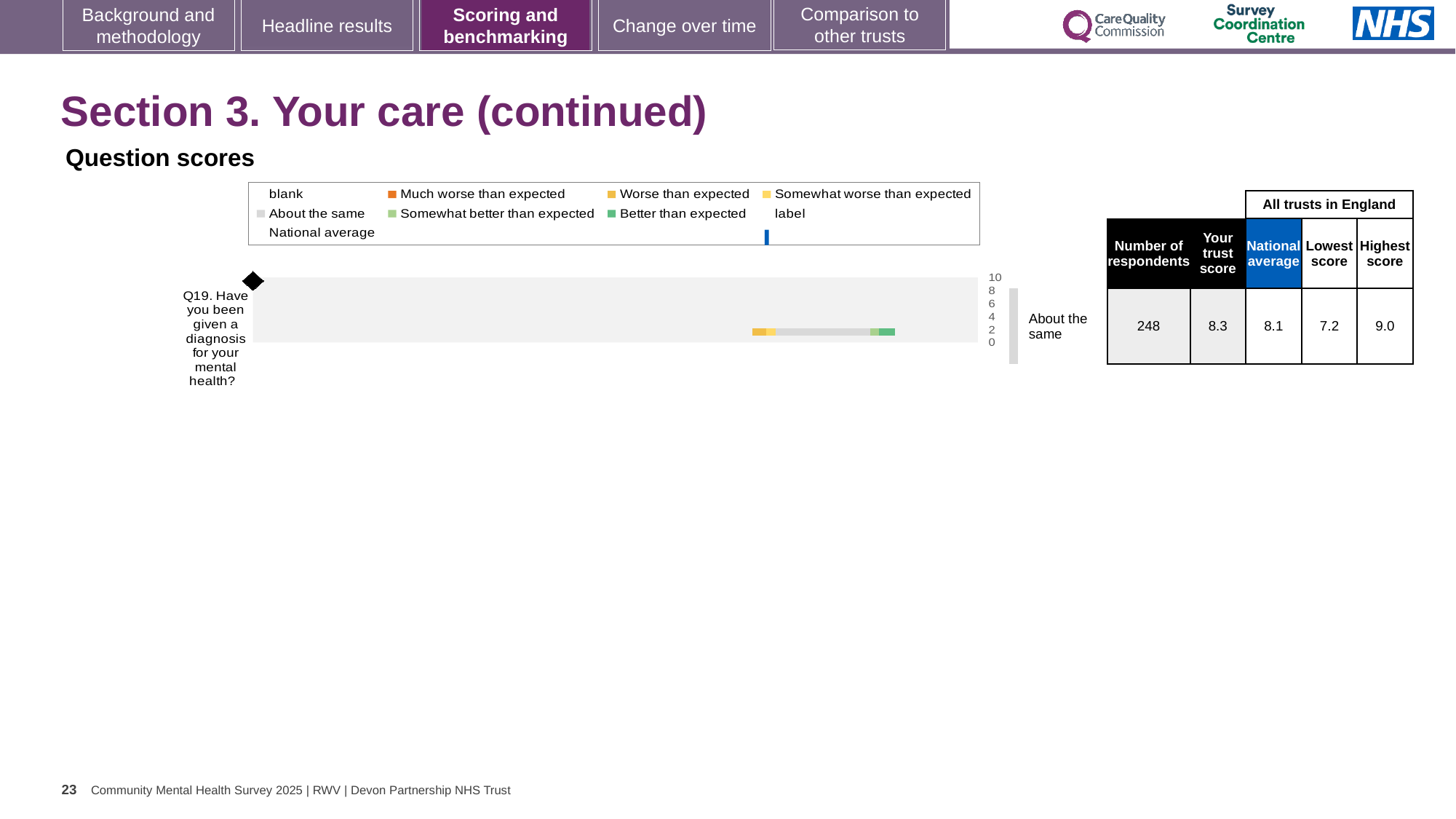
What is the difference between the highest score and the lowest score for Q19? 1.8 How many questions are plotted in the 'Question scores' chart? 1 What benchmark category is shown next to the bar for Q19? About the same What is the number of respondents for Q19 in the table? 248 What kind of chart is shown under 'Question scores'? bar chart What is the lowest score among all trusts in England for Q19? 7.2 What is 'Your trust score' for Q19 in the table? 8.3 What is the highest score among all trusts in England for Q19? 9.0 What is the maximum value shown on the chart's score axis? 10 What is the national average for Q19 in the table? 8.1 Which question is plotted in the 'Question scores' chart? Q19. Have you been given a diagnosis for your mental health? Which is larger for Q19, your trust score or the national average? Your trust score